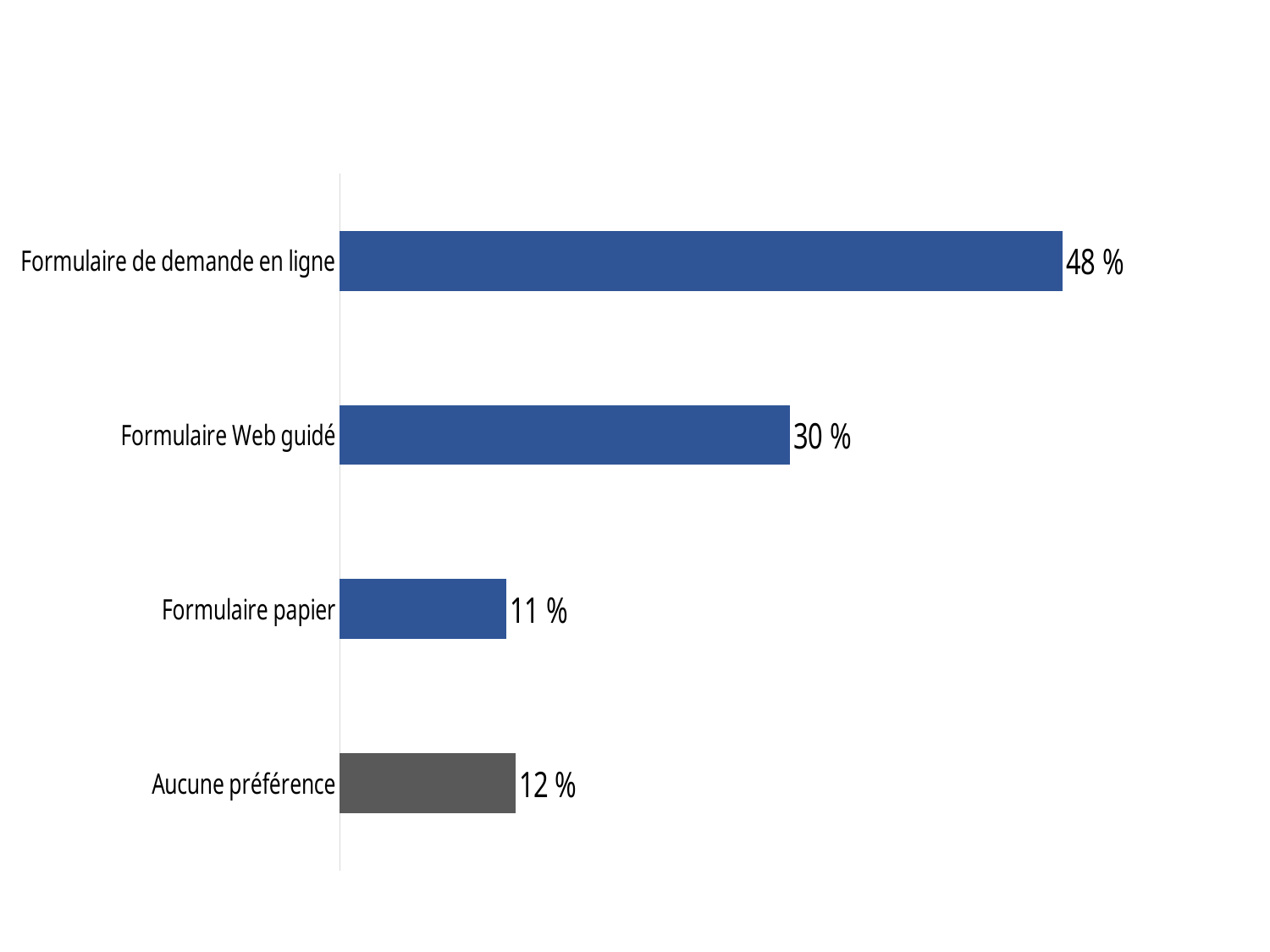
What is the value for Formulaire Web guidé? 30 % What is the value for Formulaire de demande en ligne? 48 % Which category has the lowest value? Formulaire papier What kind of chart is this? Bar chart Which is larger, Formulaire Web guidé or Formulaire papier? Formulaire Web guidé Which category has the highest value? Formulaire de demande en ligne What is the value for Aucune préférence? 12 % What is the difference between Formulaire de demande en ligne and Formulaire Web guidé? 18 % Which bar is coloured grey rather than blue? Aucune préférence What is the difference between Aucune préférence and Formulaire papier? 1 % What is the value for Formulaire papier? 11 % How many categories are shown in the chart? 4